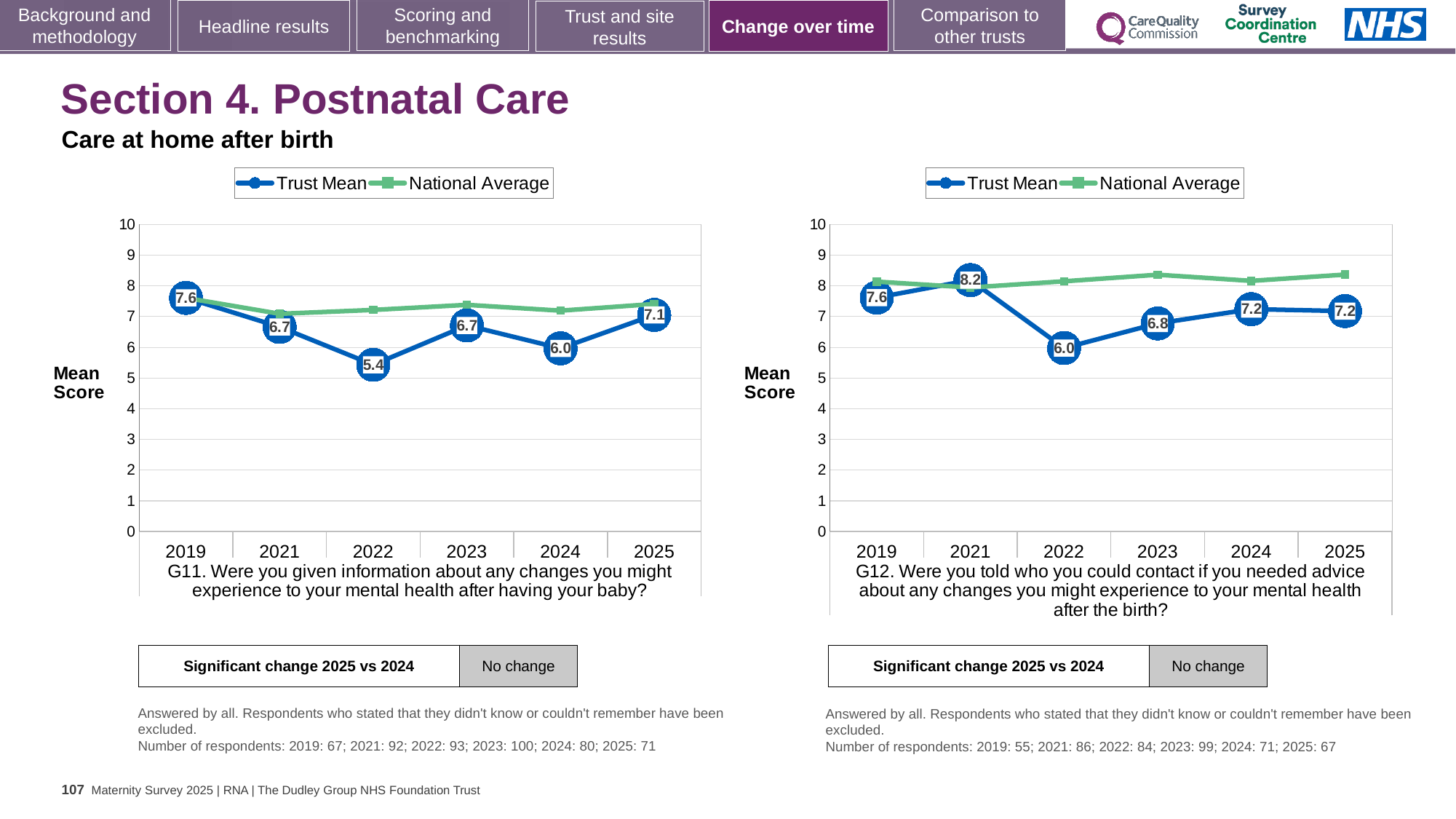
In the G11 chart on the left, what is the Trust Mean for 2022? 5.4 How many years are plotted on the x axis of the G11 chart on the left? 6 In the G12 chart on the right, which year has the lowest Trust Mean? 2022 In the G11 chart on the left, which year has the lowest Trust Mean? 2022 In the G11 chart on the left, what is the difference between the Trust Mean for 2019 and 2022? 2.2 How many series does the legend of the G12 chart on the right list? 2 In the G12 chart on the right, is the National Average for 2025 greater or less than 8? greater In the G12 chart on the right, what is the Trust Mean for 2021? 8.2 In the G11 chart on the left, which year has the highest Trust Mean? 2019 What type of chart is the G11 chart on the left? Line chart In the G11 chart on the left, what is the Trust Mean for 2025? 7.1 In the G12 chart on the right, is the Trust Mean for 2019 or 2023 larger? 2019